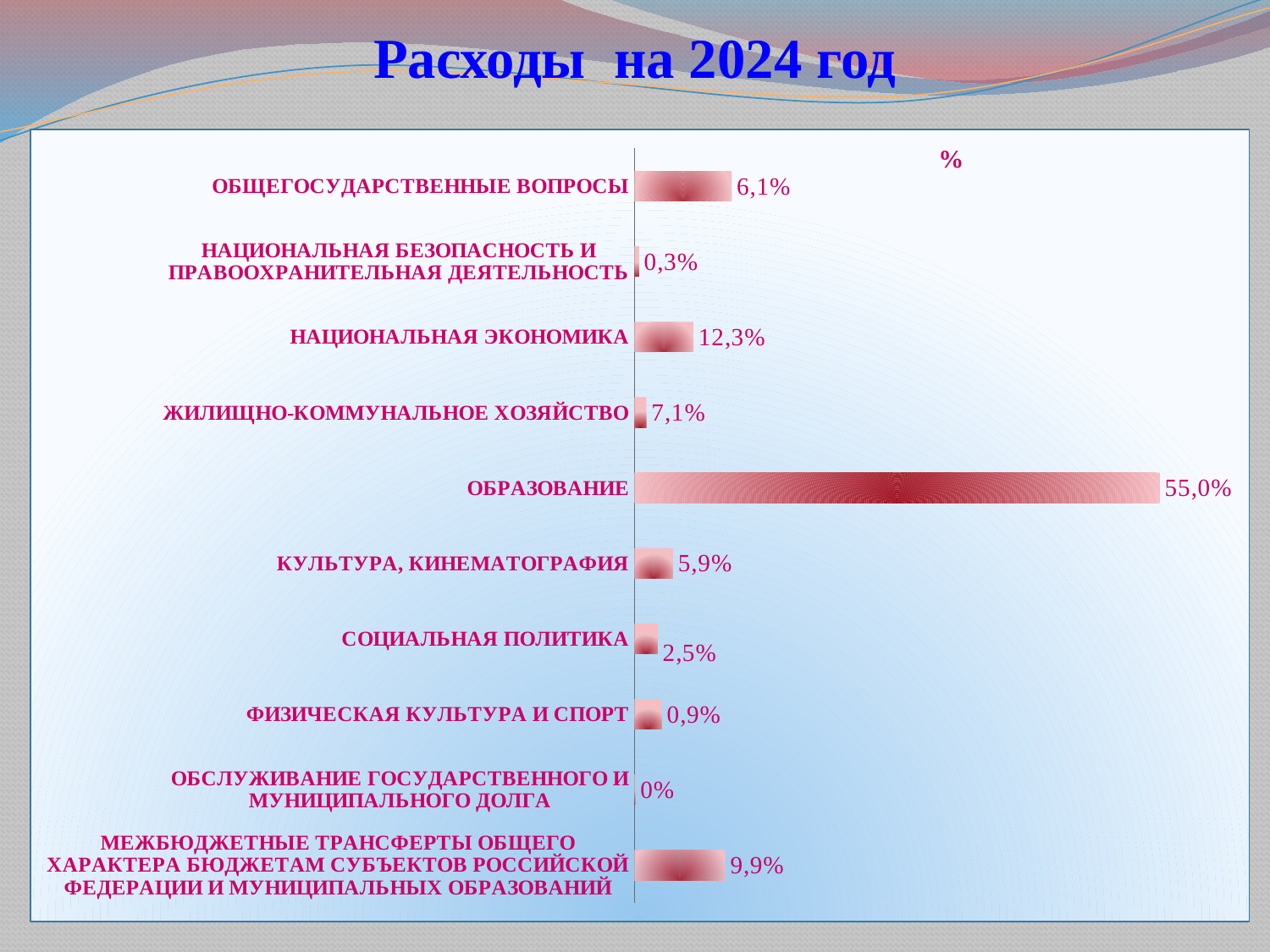
What is the value for НАЦИОНАЛЬНАЯ ЭКОНОМИКА? 12,3% Which category has the highest value? ОБРАЗОВАНИЕ What is the value for ОБСЛУЖИВАНИЕ ГОСУДАРСТВЕННОГО И МУНИЦИПАЛЬНОГО ДОЛГА? 0% What kind of chart is shown on the slide? Bar chart What is the title of the slide? Расходы на 2024 год How many categories are shown in the chart? 10 Which is larger, the value for КУЛЬТУРА, КИНЕМАТОГРАФИЯ or the value for ФИЗИЧЕСКАЯ КУЛЬТУРА И СПОРТ? КУЛЬТУРА, КИНЕМАТОГРАФИЯ What is the value for ОБРАЗОВАНИЕ? 55,0% What is the difference between the values for МЕЖБЮДЖЕТНЫЕ ТРАНСФЕРТЫ ОБЩЕГО ХАРАКТЕРА and ОБЩЕГОСУДАРСТВЕННЫЕ ВОПРОСЫ? 3,8% Which category has the lowest value? ОБСЛУЖИВАНИЕ ГОСУДАРСТВЕННОГО И МУНИЦИПАЛЬНОГО ДОЛГА What is the value for СОЦИАЛЬНАЯ ПОЛИТИКА? 2,5% What is the difference between the values for ОБРАЗОВАНИЕ and НАЦИОНАЛЬНАЯ ЭКОНОМИКА? 42,7%